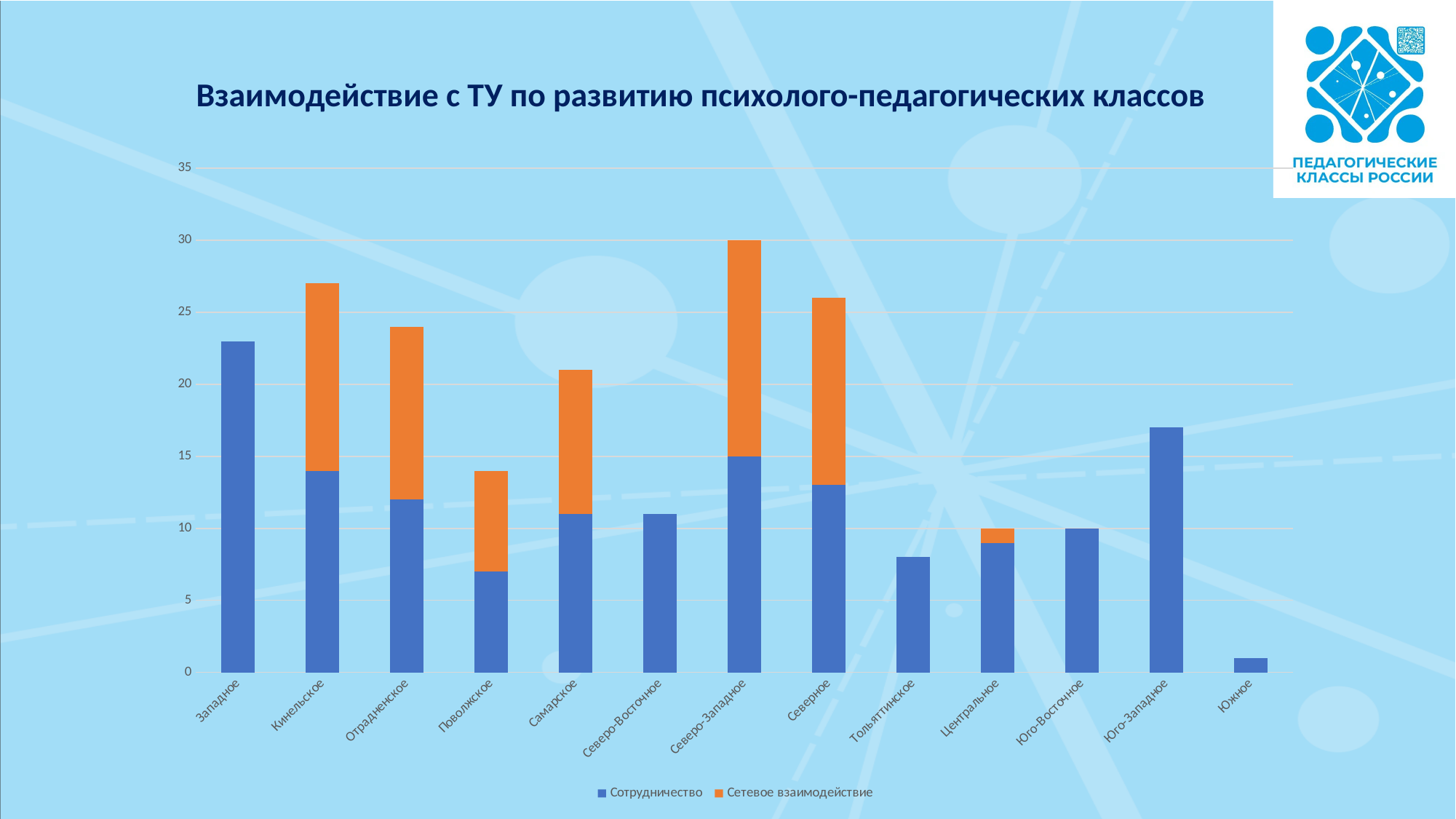
Which has the larger total bar, Кинельское or Отрадненское? Кинельское What is the value for Юго-Восточное? 10 What is the value of Сотрудничество for Северо-Западное? 15 Which category has the lowest total bar? Южное Is the total value for Тольяттинское greater or less than 10? less What kind of chart is shown on the slide? bar chart Which series is shown in orange in the legend? Сетевое взаимодействие Is the total value for Западное greater or less than 20? greater Which category has the highest total bar? Северо-Западное How many categories (territorial units) are shown on the x axis? 13 What is the total value of the stacked bar for Северо-Западное? 30 How many series does the legend list? 2